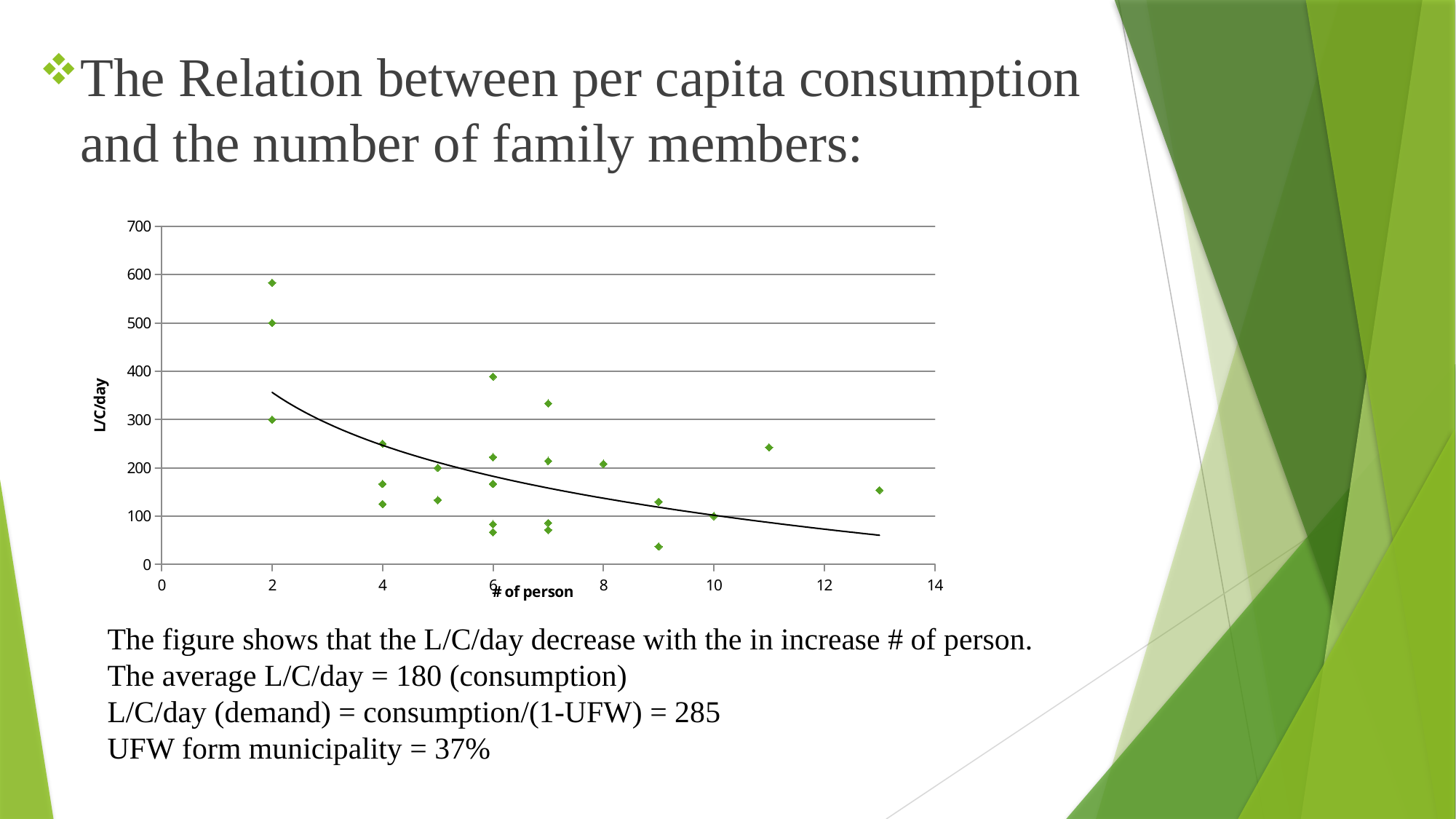
What kind of chart is shown on the slide? scatter chart At what number of persons is the highest L/C/day point plotted? 2 What is the label of the x axis of the chart? # of person What is the maximum value shown on the y axis of the chart? 700 Which is larger: the point plotted at 11 persons or the point plotted at 13 persons? 11 persons Is the lowest point plotted at 9 persons greater or less than 100 L/C/day? less Is the point plotted at 11 persons greater or less than 200 L/C/day? greater At what number of persons is the lowest L/C/day point plotted? 9 What is the label of the y axis of the chart? L/C/day Is the point plotted at 13 persons greater or less than 200 L/C/day? less Does L/C/day rise or fall as the number of persons increases along the x axis? fall